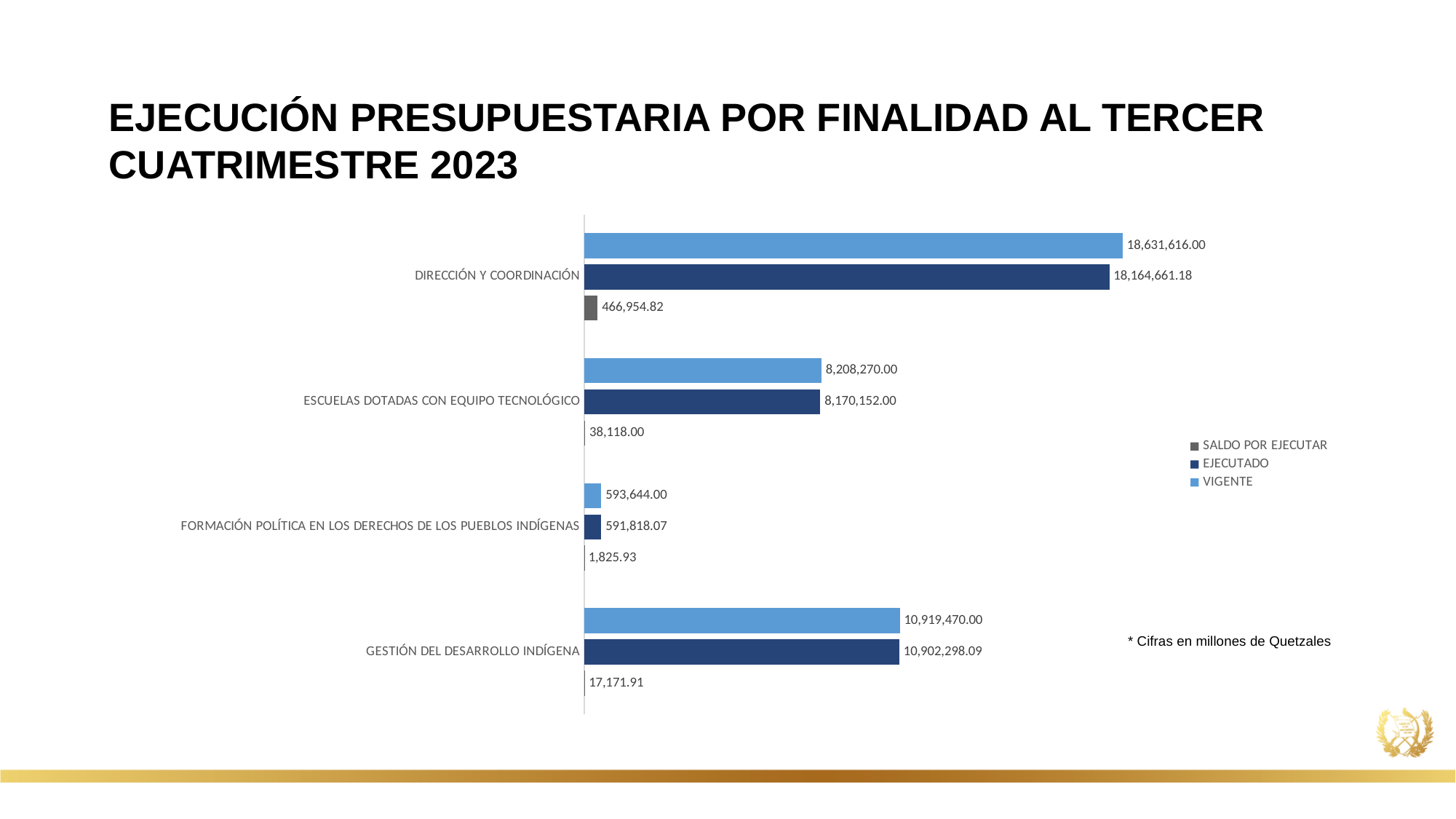
How many categories are shown on the chart? 4 What is the EJECUTADO value for ESCUELAS DOTADAS CON EQUIPO TECNOLÓGICO? 8,170,152.00 What is the SALDO POR EJECUTAR value for GESTIÓN DEL DESARROLLO INDÍGENA? 17,171.91 Which category has the lowest VIGENTE value? FORMACIÓN POLÍTICA EN LOS DERECHOS DE LOS PUEBLOS INDÍGENAS Which is larger, the EJECUTADO value for GESTIÓN DEL DESARROLLO INDÍGENA or the EJECUTADO value for ESCUELAS DOTADAS CON EQUIPO TECNOLÓGICO? GESTIÓN DEL DESARROLLO INDÍGENA What is the VIGENTE value for FORMACIÓN POLÍTICA EN LOS DERECHOS DE LOS PUEBLOS INDÍGENAS? 593,644.00 Which legend entry is shown in grey? SALDO POR EJECUTAR Which category has the highest EJECUTADO value? DIRECCIÓN Y COORDINACIÓN What is the VIGENTE value for DIRECCIÓN Y COORDINACIÓN? 18,631,616.00 What kind of chart is shown on the slide? Bar chart What is the difference between the VIGENTE and EJECUTADO values for ESCUELAS DOTADAS CON EQUIPO TECNOLÓGICO? 38,118.00 How many series does the legend list? 3